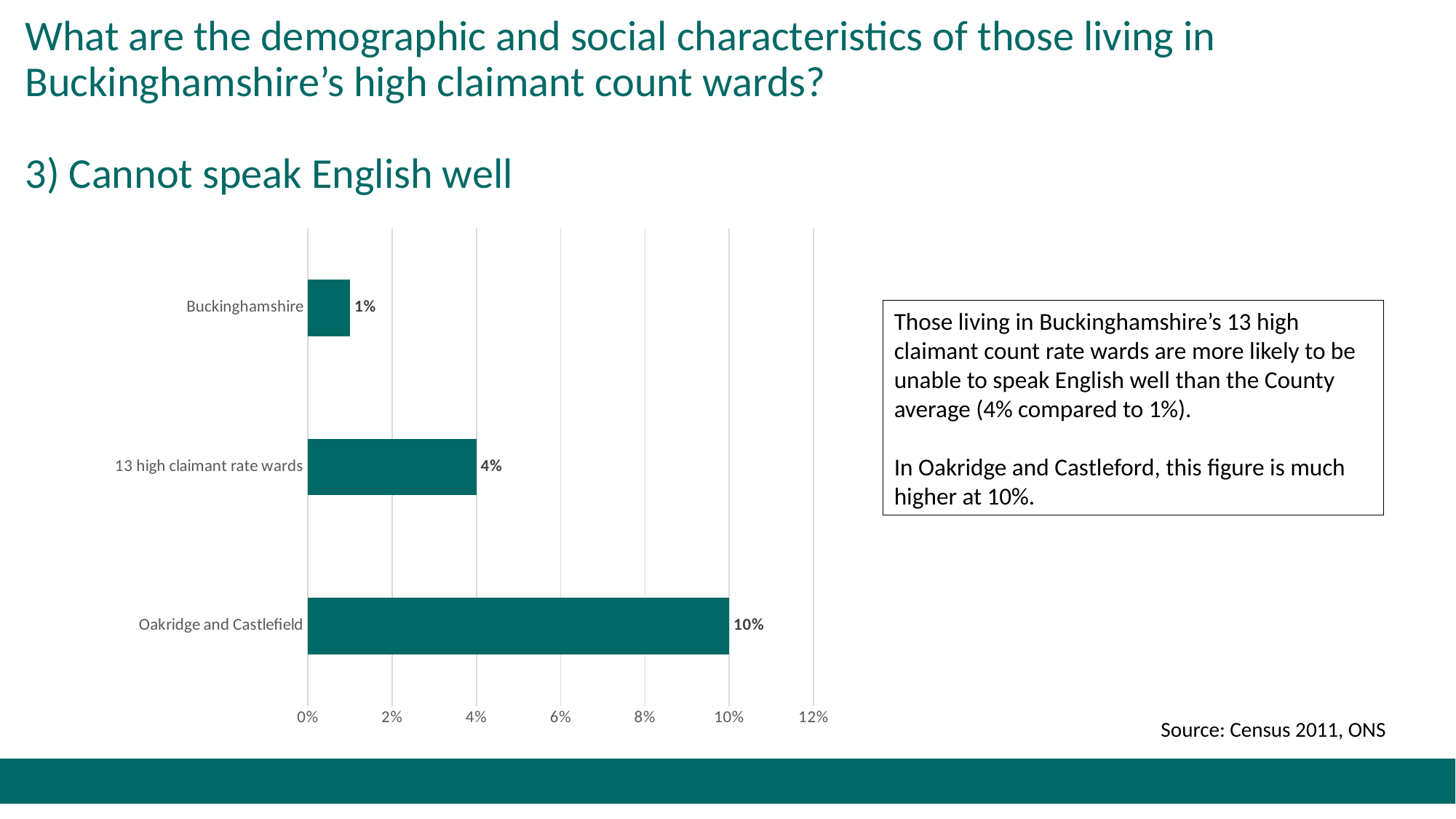
What is the value for 13 high claimant rate wards? 4% What is the value for Buckinghamshire? 1% Which category has the highest value? Oakridge and Castlefield What is the difference between the values for Oakridge and Castlefield and Buckinghamshire? 9% Which category has the lowest value? Buckinghamshire Which is larger, the value for 13 high claimant rate wards or the value for Buckinghamshire? 13 high claimant rate wards How many categories are shown in the chart? 3 What is the maximum value shown on the x axis? 12% Is the value for Oakridge and Castlefield greater or less than 8%? greater What kind of chart is shown on the slide? Bar chart What is the difference between the values for 13 high claimant rate wards and Buckinghamshire? 3% What is the value for Oakridge and Castlefield? 10%